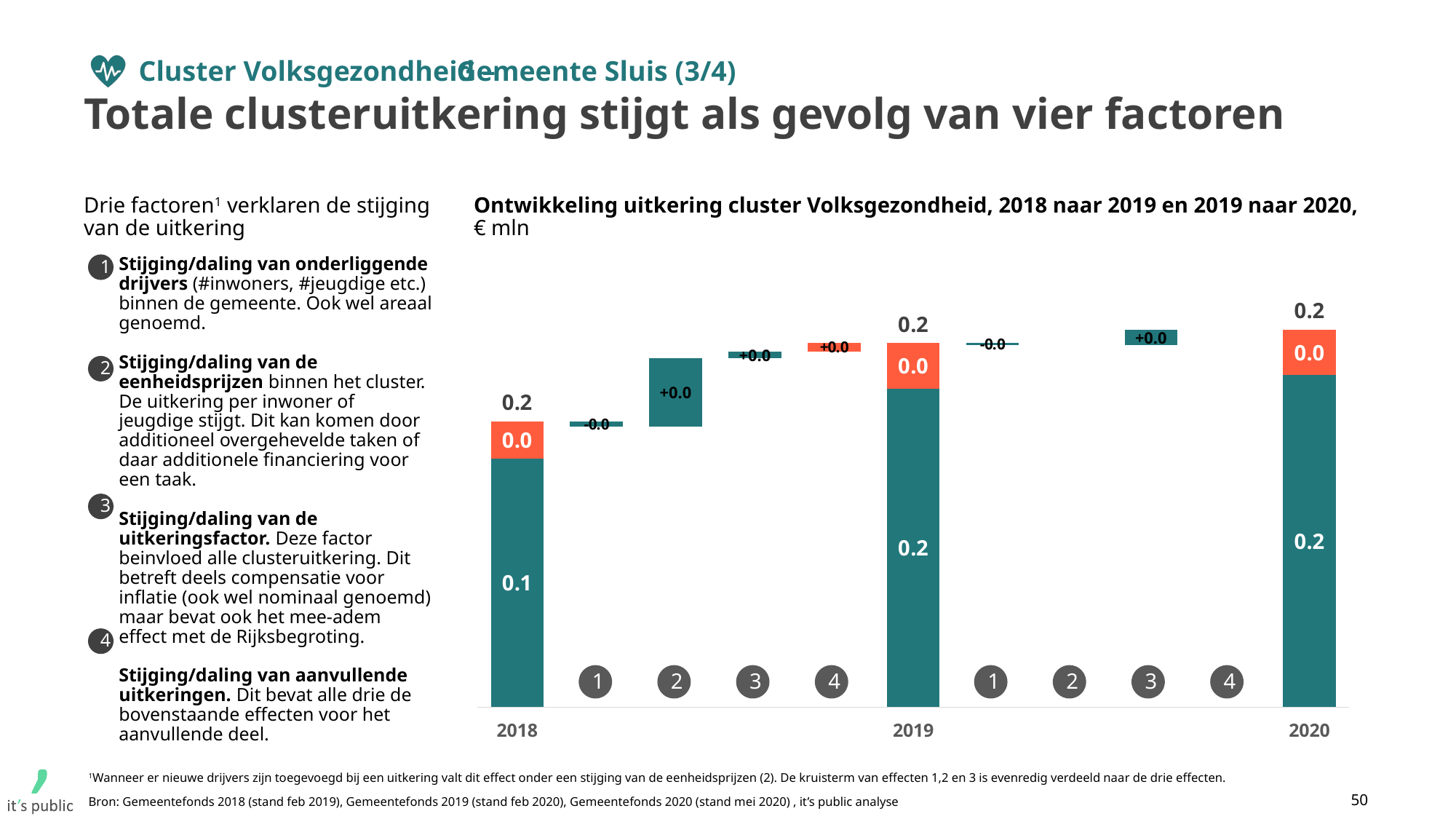
Which year has the larger teal segment, 2018 or 2019? 2019 In what unit are the values in the chart expressed, according to the chart title? € mln What is the total value shown above the 2018 bar? 0.2 What value is printed on the orange (upper) segment of the 2020 bar? 0.0 What value is printed on the teal (lower) segment of the 2018 bar? 0.1 What is the label on the factor 2 step between 2018 and 2019? +0.0 What is the label on the factor 1 step between 2019 and 2020? -0.0 What value is printed on the teal (lower) segment of the 2019 bar? 0.2 What is the difference between the teal segment of 2019 and the teal segment of 2018? 0.1 What is the total value shown above the 2020 bar? 0.2 How many year totals (2018, 2019, 2020) are shown as full bars in the chart? 3 What kind of chart is shown on the slide? Bar chart (waterfall)